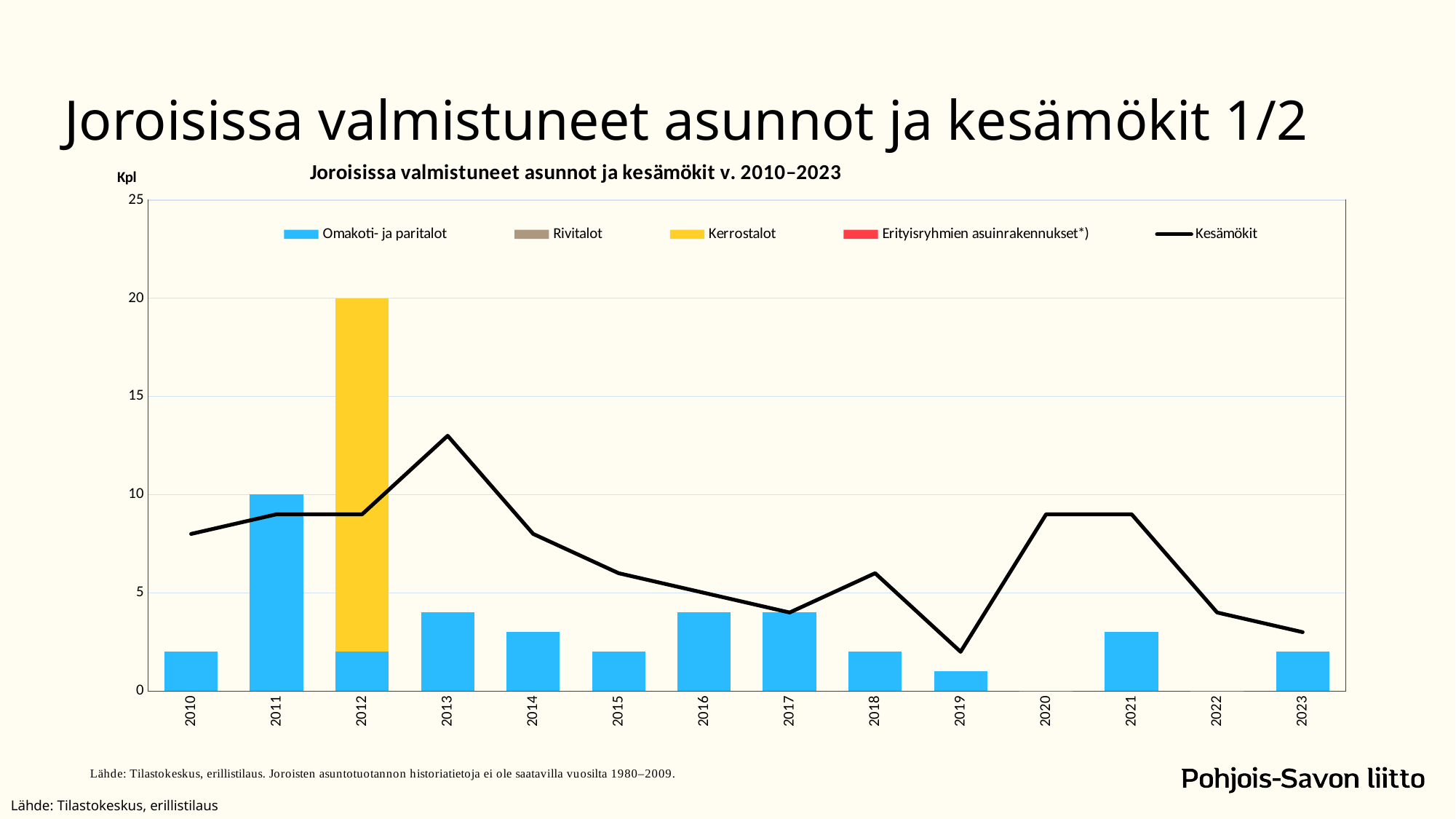
What kind of chart is shown on the slide? A combined bar and line chart In which year does a Kerrostalot (yellow) bar appear? 2012 What is the value of Omakoti- ja paritalot in 2011? 10 Is the Kesämökit value for 2013 greater or less than 10? greater What is the total height of the stacked bar for 2012? 20 How many years are shown on the x axis? 14 How many series does the legend list? 5 In which year is the Kesämökit line at its highest? 2013 Which is larger, the Omakoti- ja paritalot value for 2011 or for 2013? 2011 In which year is the Kesämökit line at its lowest? 2019 Is the Kerrostalot value for 2012 greater or less than 15? greater Does the Kesämökit line rise or fall from 2013 to 2017? It falls